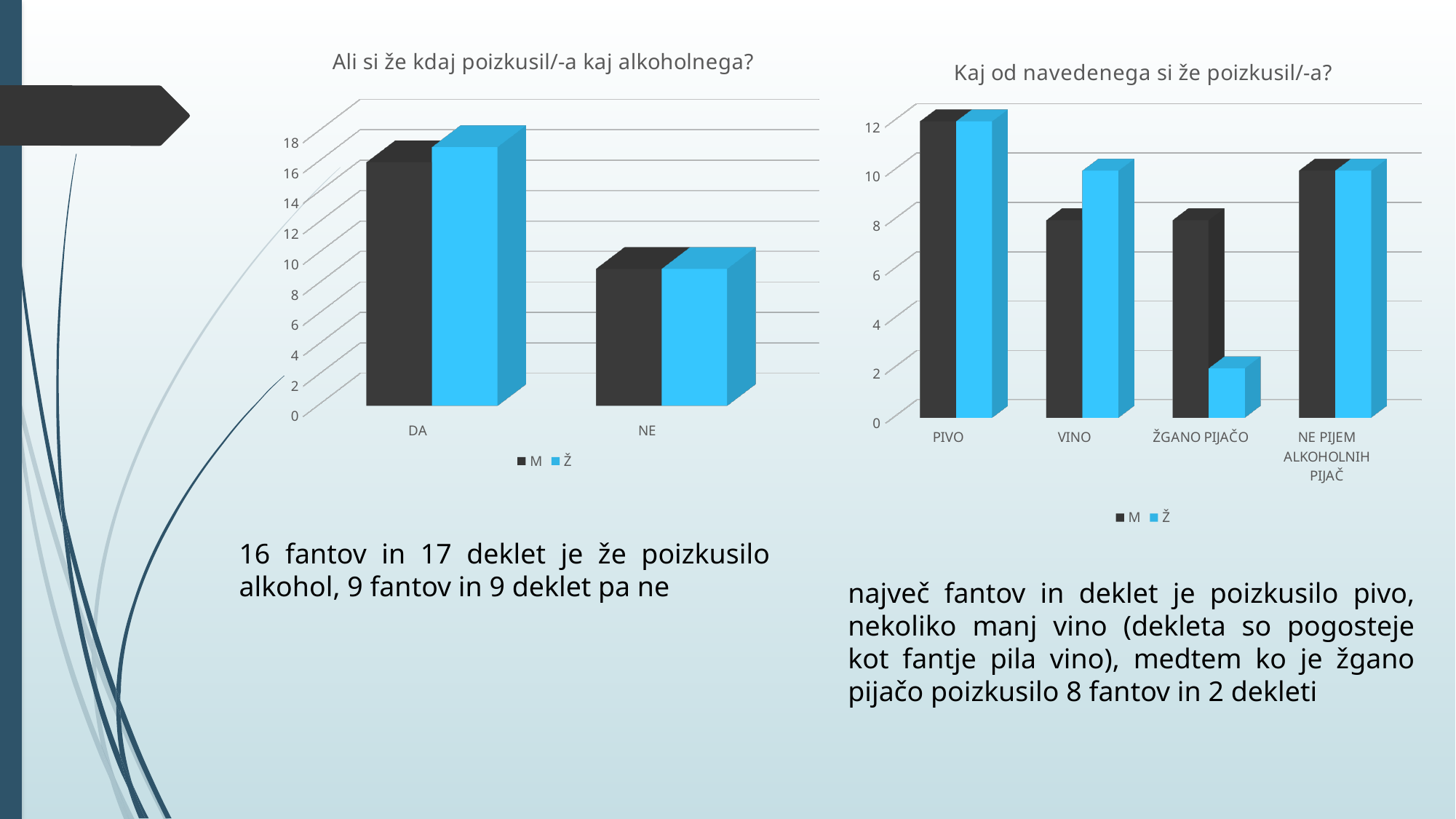
In the chart titled "Ali si že kdaj poizkusil/-a kaj alkoholnega?", do the values for M rise or fall from DA to NE? fall In the chart titled "Kaj od navedenega si že poizkusil/-a?", what is the value of Ž for VINO? 10 In the chart titled "Kaj od navedenega si že poizkusil/-a?", what is the value of M for ŽGANO PIJAČO? 8 In the chart titled "Kaj od navedenega si že poizkusil/-a?", which category has the lowest value for Ž? ŽGANO PIJAČO In the chart titled "Kaj od navedenega si že poizkusil/-a?", what is the value of Ž for ŽGANO PIJAČO? 2 How many categories are shown on the x axis of the chart titled "Kaj od navedenega si že poizkusil/-a?"? 4 What kind of chart is the chart titled "Kaj od navedenega si že poizkusil/-a?"? bar chart In the chart titled "Ali si že kdaj poizkusil/-a kaj alkoholnega?", is the value of Ž for NE greater or less than 12? less In the chart titled "Kaj od navedenega si že poizkusil/-a?", which is larger for VINO, M or Ž? Ž How many series does the legend list in the chart titled "Ali si že kdaj poizkusil/-a kaj alkoholnega?"? 2 In the chart titled "Kaj od navedenega si že poizkusil/-a?", which category has the highest value for Ž? PIVO In the chart titled "Kaj od navedenega si že poizkusil/-a?", what is the difference between M and Ž for ŽGANO PIJAČO? 6